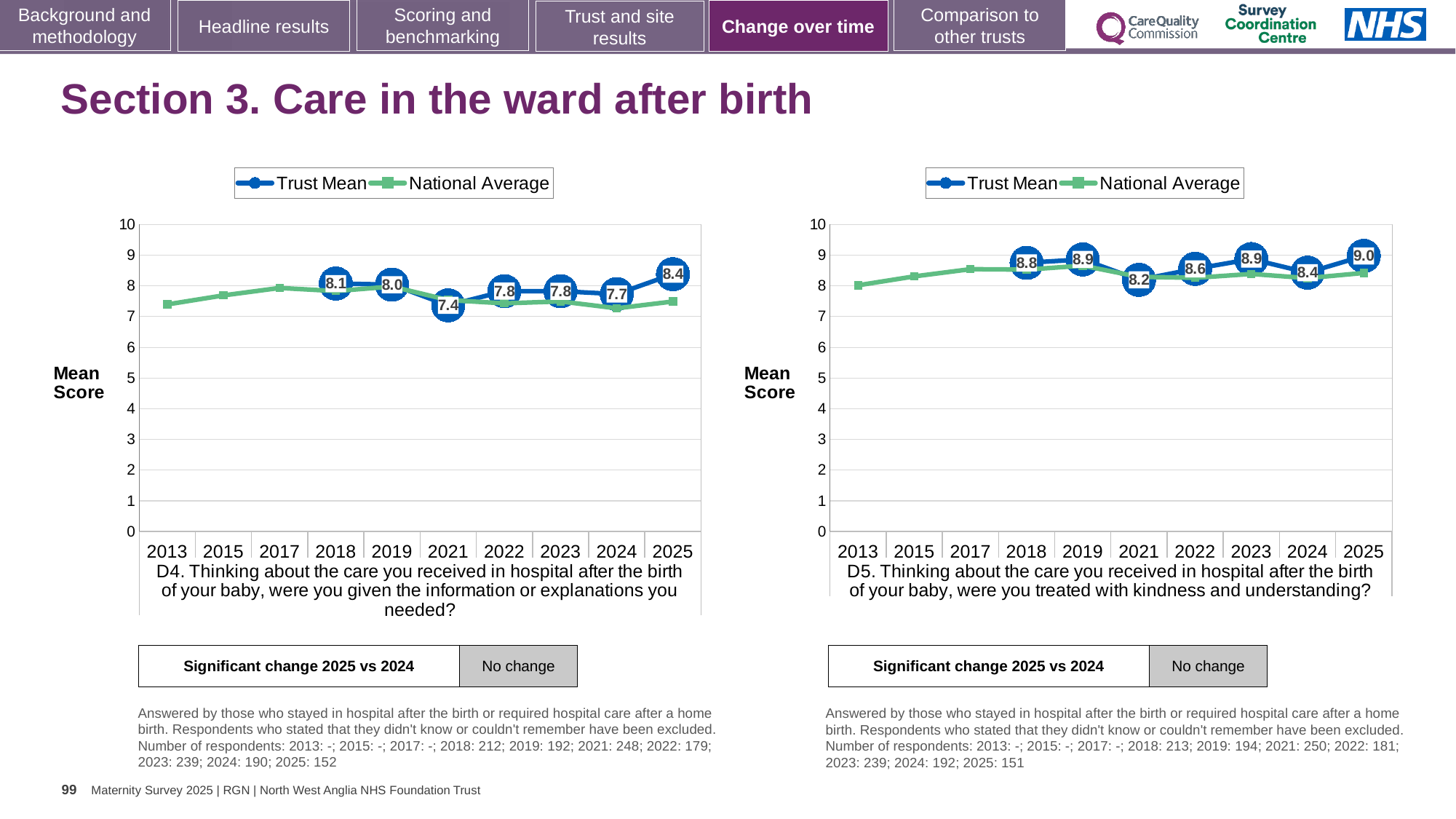
How many series does the legend of the left chart (D4) list? 2 On the right chart (D5), what does the 'Significant change 2025 vs 2024' box say? No change On the right chart (D5), what is the Trust Mean score for 2024? 8.4 On the left chart (D4), is the National Average value for 2013 greater or less than 8? less How many years are shown on the x axis of the right chart (D5)? 10 On the left chart (D4), which year has the lowest Trust Mean score? 2021 On the left chart (D4), is the Trust Mean score higher in 2018 or in 2024? 2018 On the right chart (D5), which year has the highest Trust Mean score? 2025 On the left chart (D4), what is the Trust Mean score for 2025? 8.4 On the left chart (D4), what is the Trust Mean score for 2021? 7.4 What kind of chart is the right chart (D5)? Line chart On the right chart (D5), what is the difference between the Trust Mean scores for 2025 and 2021? 0.8